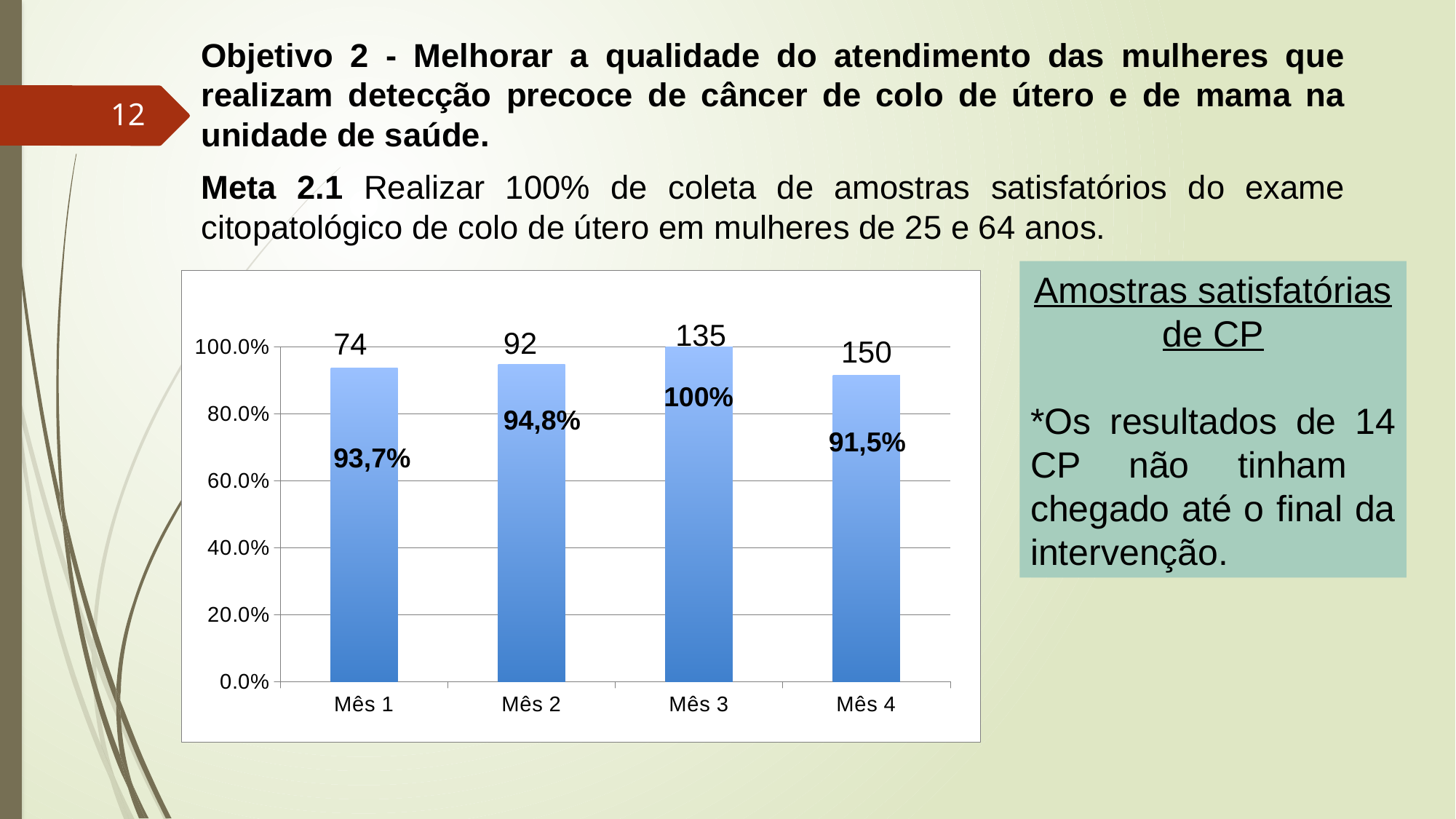
How many months are shown on the x axis? 4 Do the numbers printed above the bars rise or fall from Mês 1 to Mês 4? rise What kind of chart is shown on the slide? bar chart Which month has the highest percentage? Mês 3 Which has a higher percentage, Mês 2 or Mês 4? Mês 2 What number is printed above the bar for Mês 3? 135 What percentage is shown for Mês 1? 93,7% What is the difference between the numbers printed above the bars for Mês 4 and Mês 1? 76 Which month has the lowest percentage? Mês 4 Is the value for Mês 4 greater or less than 80.0%? greater What percentage is shown for Mês 4? 91,5% What percentage is shown for Mês 2? 94,8%